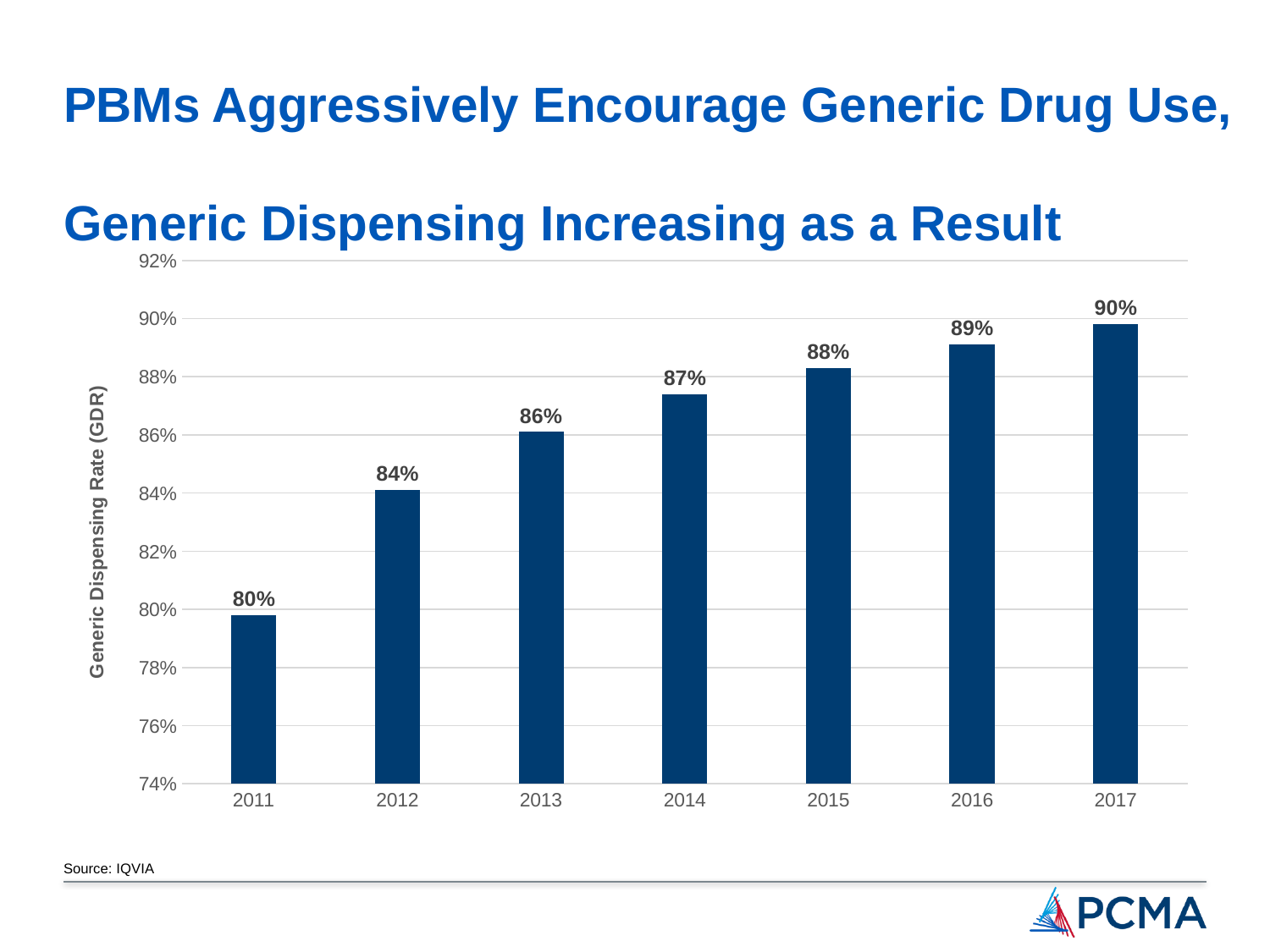
What kind of chart is shown on the slide? Bar chart What is the difference in Generic Dispensing Rate between 2017 and 2011? 10% Which year has the lowest Generic Dispensing Rate? 2011 Is the value for 2016 greater or less than 88%? greater Do the Generic Dispensing Rate values rise or fall from 2011 to 2017? Rise What is the Generic Dispensing Rate for 2014? 87% Which year has the highest Generic Dispensing Rate? 2017 What is the difference in Generic Dispensing Rate between 2013 and 2012? 2% What is the Generic Dispensing Rate for 2011? 80% Which year has a higher Generic Dispensing Rate, 2012 or 2015? 2015 How many years are shown on the x axis of the chart? 7 What is the Generic Dispensing Rate for 2017? 90%